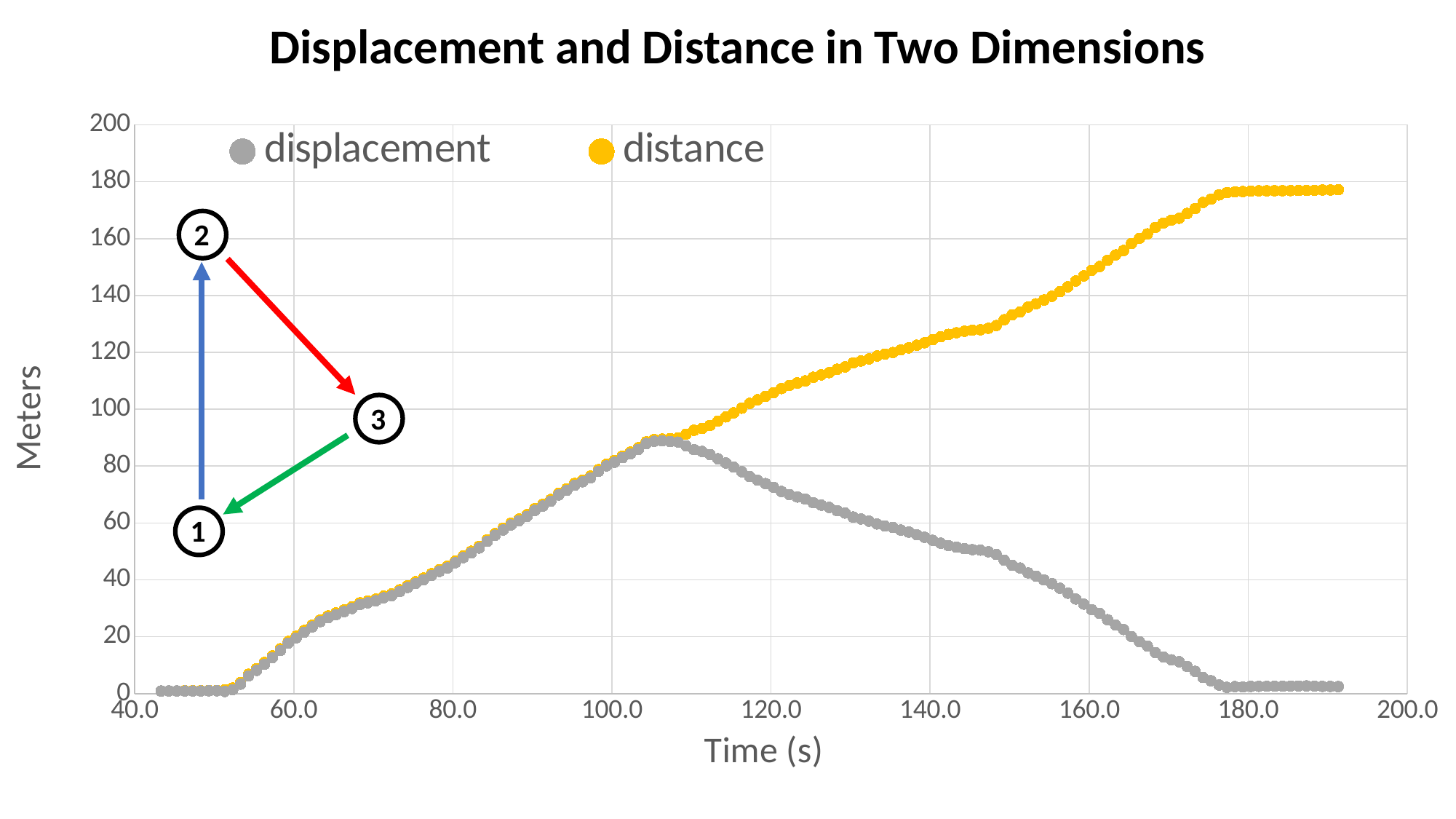
What kind of chart is shown on the slide? scatter chart What is the label of the x axis? Time (s) Is the value of the displacement series at 180.0 s greater or less than 20? less Does the distance series rise or fall overall as time increases along the x axis? rise Is the value of the distance series at 180.0 s greater or less than 160? greater Is the value of the displacement series at 140.0 s greater or less than 80? less How many series does the legend list? 2 What is the title of the chart? Displacement and Distance in Two Dimensions At 160.0 s, which series has the larger value, displacement or distance? distance Which series ends at the higher value at the right end of the chart? distance